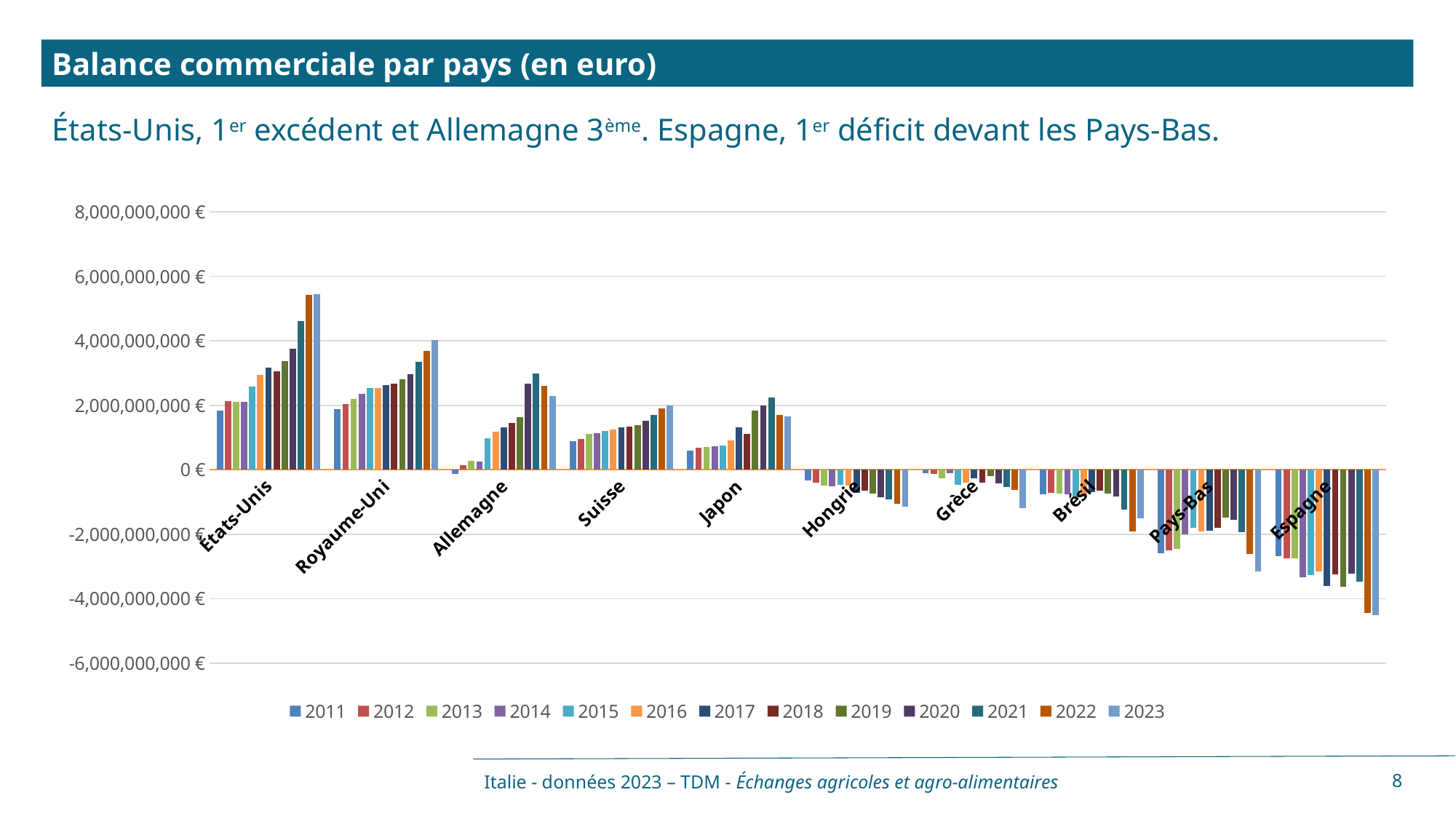
What is the title of the chart on the slide? Balance commerciale par pays (en euro) Which country has the highest bar in the chart? États-Unis Which country has the lowest (most negative) bar in the chart? Espagne What kind of chart is shown on the slide? bar chart Is the 2023 value for Espagne greater or less than -4,000,000,000 €? less Do the bars for États-Unis generally rise or fall from 2011 to 2023? rise Is the 2023 value for États-Unis greater or less than 4,000,000,000 €? greater Is the 2023 value for Pays-Bas greater or less than -2,000,000,000 €? less How many countries are shown on the x axis of the chart? 10 How many series (years) does the chart legend list? 13 Which has the larger 2023 value, États-Unis or Royaume-Uni? États-Unis